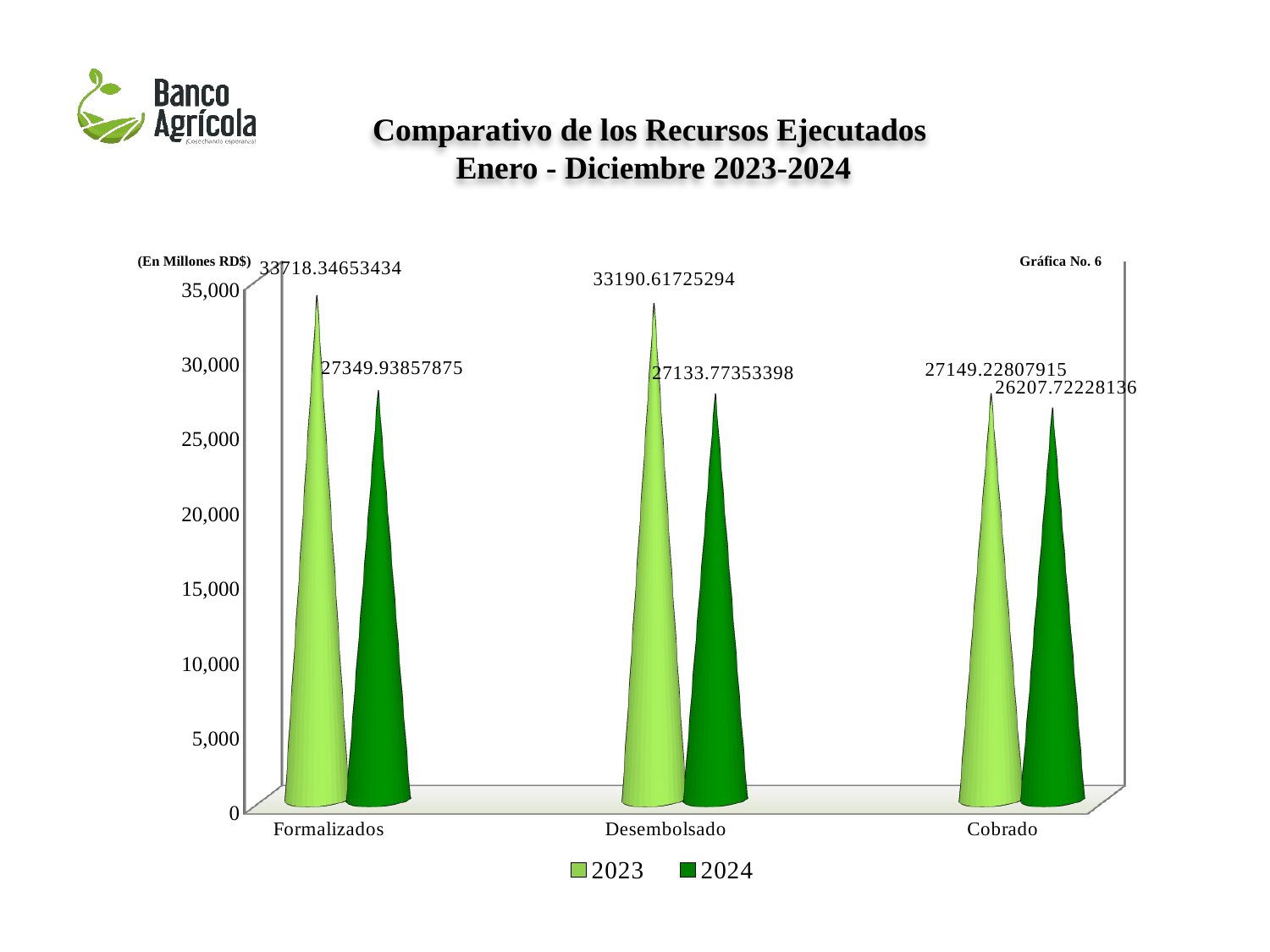
What is the value for Cobrado in 2024? 26207.72228136 What unit is indicated for the values on the chart? En Millones RD$ What is the value for Cobrado in 2023? 27149.22807915 Which category has the highest value for 2023? Formalizados Is the value for Cobrado in 2024 greater or less than 30,000? less How many series does the legend list? 2 Which category has the lowest value for 2024? Cobrado What is the value for Desembolsado in 2024? 27133.77353398 How many categories are shown on the x axis? 3 What is the difference between the 2023 and 2024 values for Cobrado? 941.50579779 Which is larger for Desembolsado, the 2023 value or the 2024 value? 2023 What is the value for Formalizados in 2023? 33718.34653434